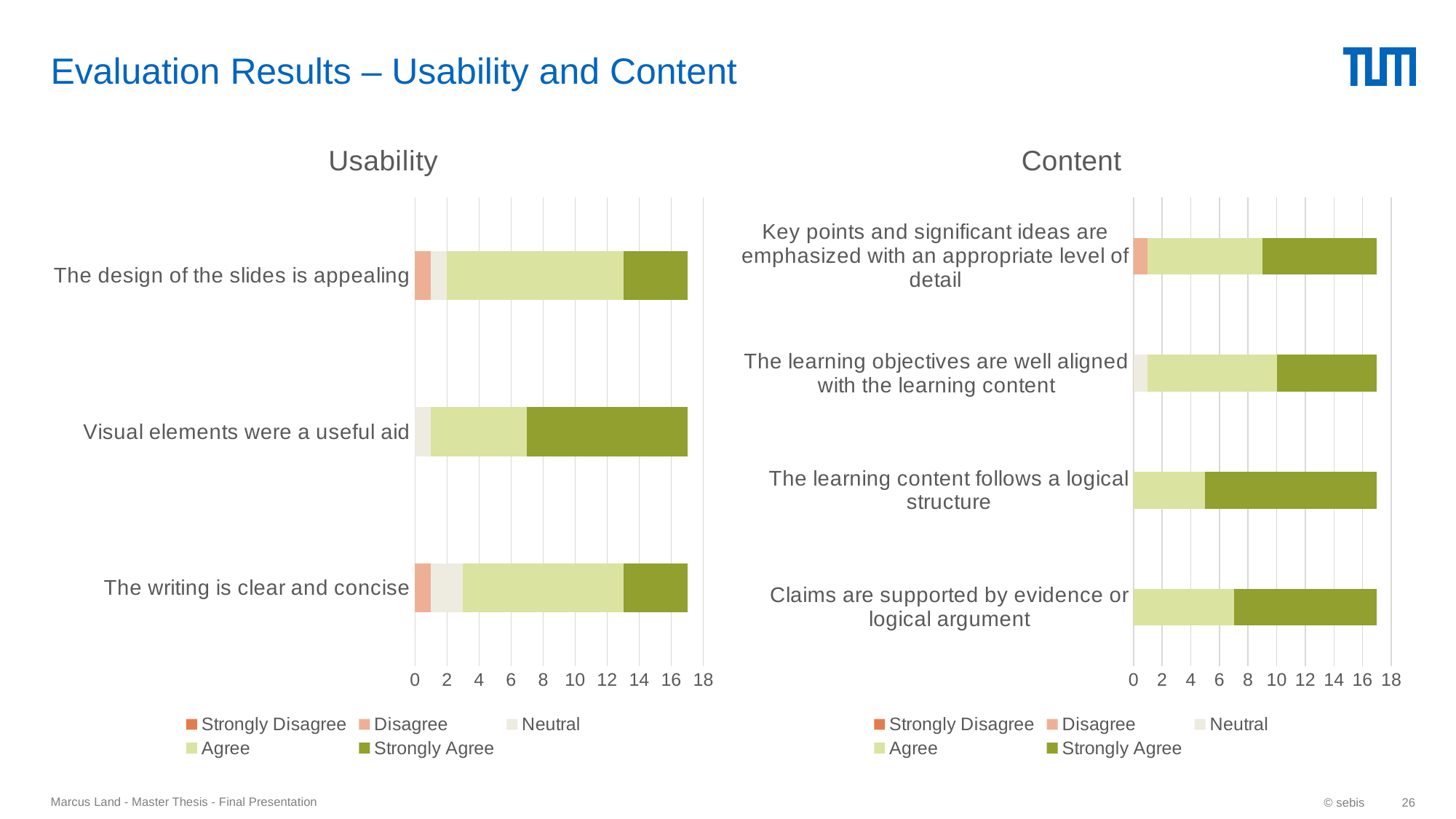
In the Usability chart, is the 'Strongly Agree' segment for 'The design of the slides is appealing' greater or less than 6? less In the Usability chart, which statement has no 'Disagree' segment? Visual elements were a useful aid How many categories (statements) are shown in the Content chart? 4 In the Usability chart, which has the larger 'Strongly Agree' segment: 'Visual elements were a useful aid' or 'The design of the slides is appealing'? Visual elements were a useful aid In the Usability chart, is the total bar length for 'Visual elements were a useful aid' greater or less than 16? greater What type of chart is the Usability chart? Stacked bar chart How many series does the legend of the Content chart list? 5 How many categories (statements) are shown in the Usability chart? 3 In the Usability chart, which statement has the largest 'Strongly Agree' segment? Visual elements were a useful aid In the Content chart, which statement has the largest 'Strongly Agree' segment? The learning content follows a logical structure What is the title of the chart on the right side of the slide? Content In the Content chart, is the total bar length for 'The learning content follows a logical structure' greater or less than 16? greater